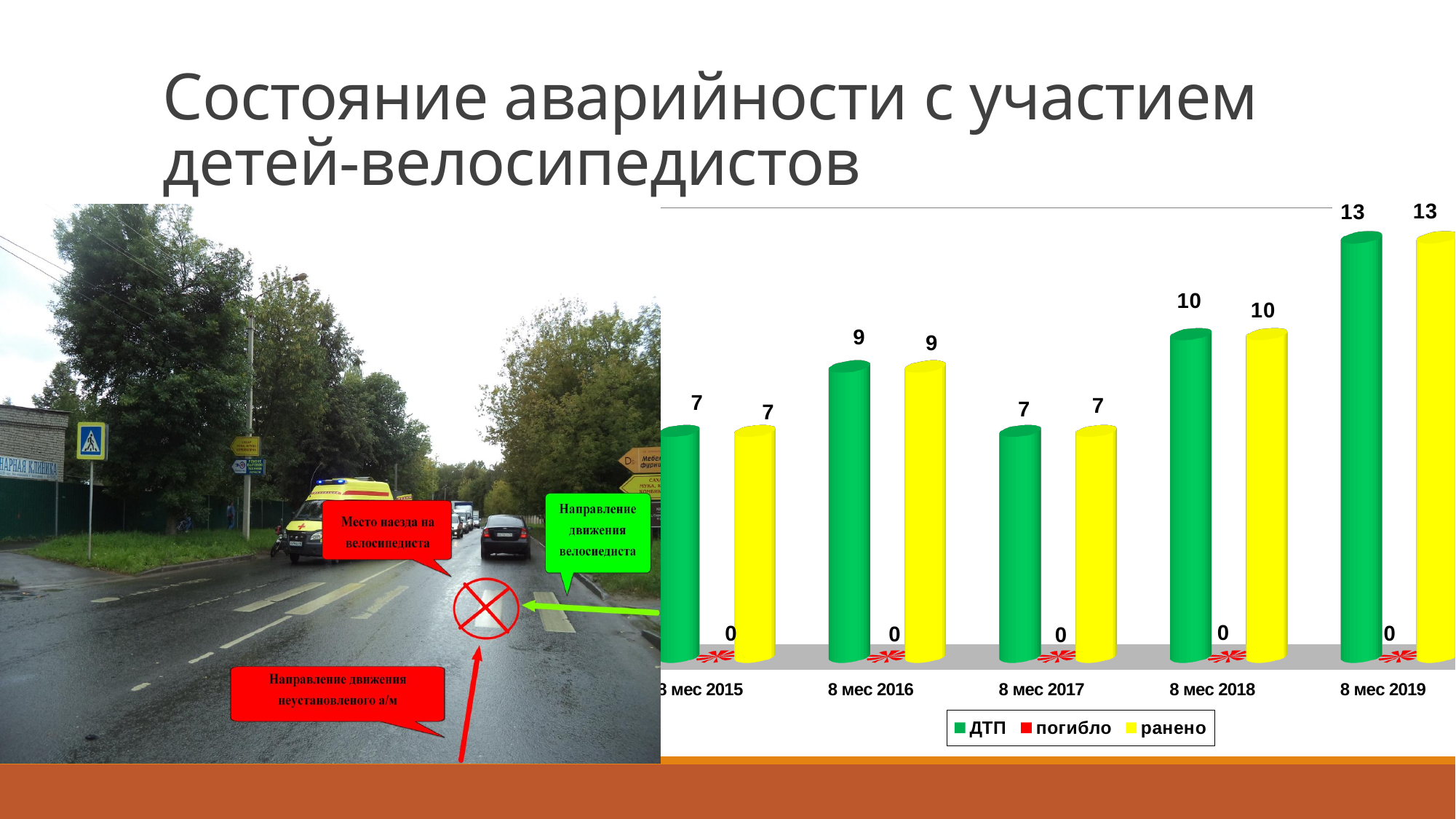
How many series does the chart legend list? 3 Which period has the highest value of ДТП? 8 мес 2019 How many categories (periods) are shown on the x axis of the chart? 5 What is the value of ДТП for 8 мес 2019? 13 What is the value of ранено for 8 мес 2016? 9 Does the ДТП value rise or fall from 8 мес 2017 to 8 мес 2019? rise What is the value of ДТП for 8 мес 2017? 7 Which colour represents the series ранено in the chart? yellow Which is larger: the ранено value for 8 мес 2016 or for 8 мес 2017? 8 мес 2016 What is the difference between the ДТП value for 8 мес 2019 and for 8 мес 2018? 3 What is the value of погибло for 8 мес 2018? 0 What kind of chart is shown on the right side of the slide? bar chart